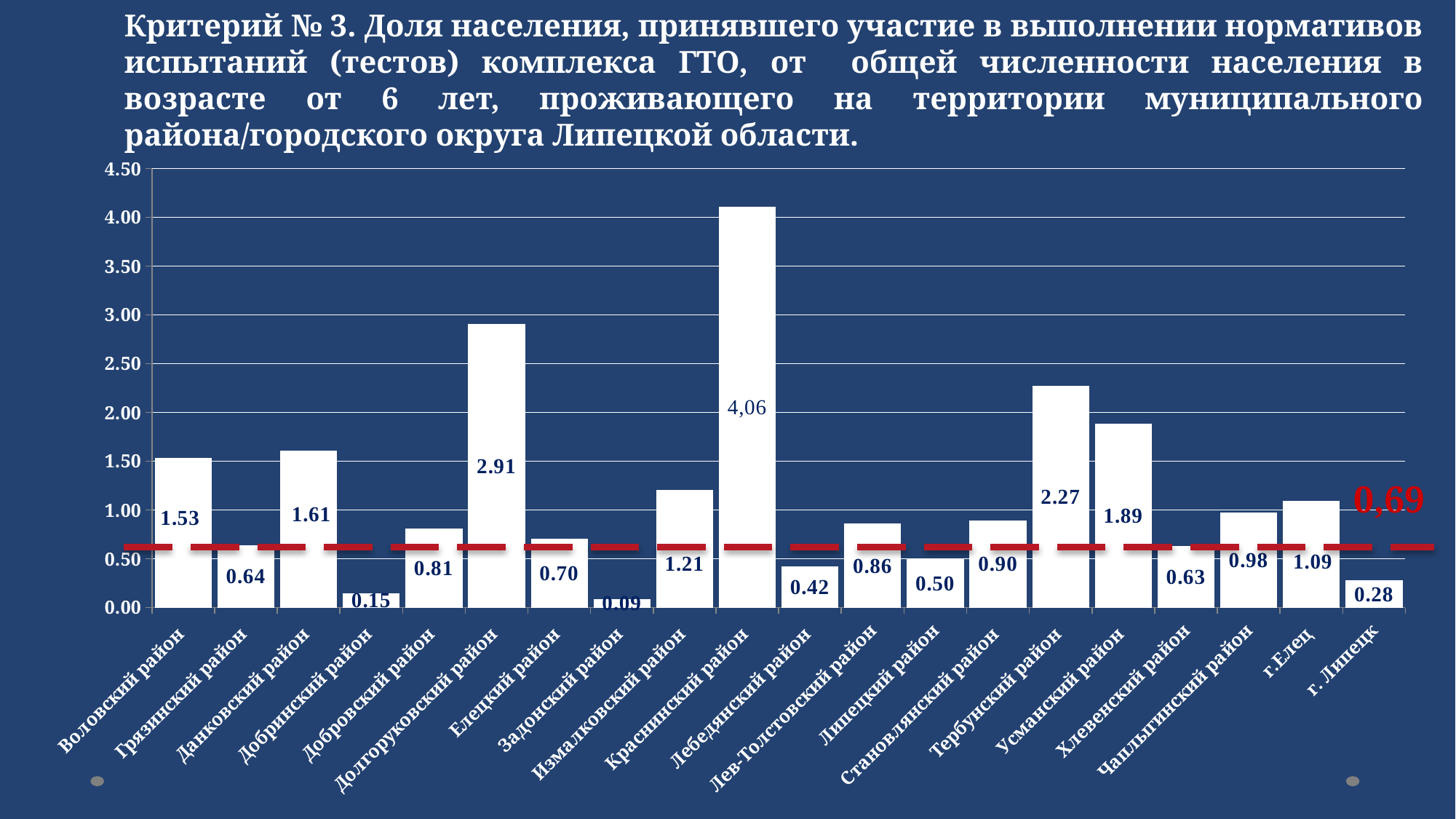
Which district has the lowest value? Задонский район What is the value for Долгоруковский район? 2.91 What is the value for Усманский район? 1.89 How many districts/cities are shown on the x axis? 20 What is the difference between the values for Данковский район and Воловский район? 0.08 What value is labelled on the red dashed horizontal line? 0,69 What is the difference between the values for Долгоруковский район and Тербунский район? 0.64 Which is larger, the value for Измалковский район or the value for г.Елец? Измалковский район What is the value for г. Липецк? 0.28 Is the value for Тербунский район greater or less than 2.00? greater What kind of chart is shown on the slide? bar chart Which district has the highest value? Краснинский район